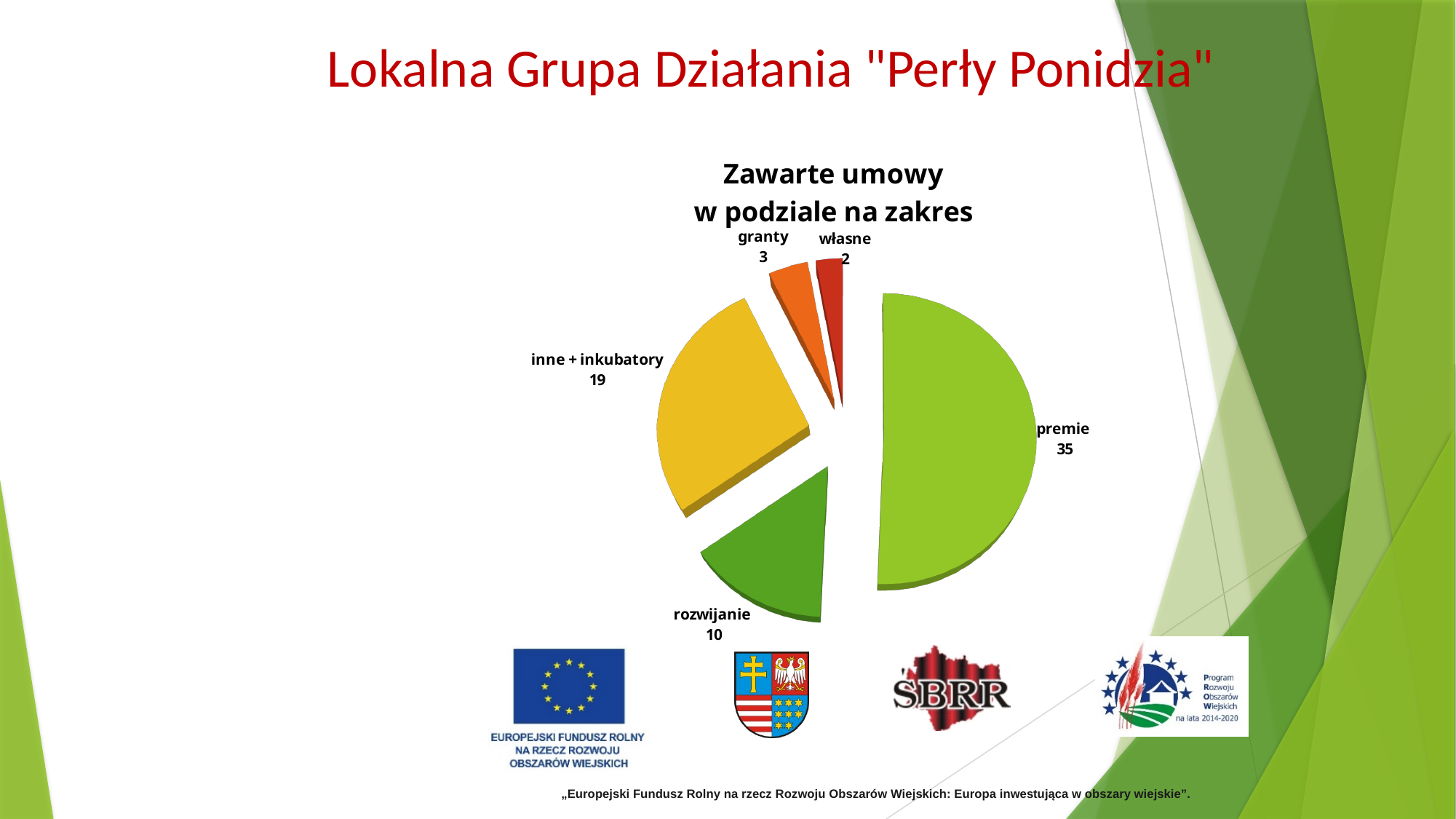
What kind of chart is shown on the slide? pie chart Which is larger, rozwijanie or granty? rozwijanie What is the value for premie? 35 What is the value for inne + inkubatory? 19 How many slices does the pie chart have? 5 What is the value for rozwijanie? 10 What is the value for granty? 3 What is the title of the chart? Zawarte umowy w podziale na zakres What is the difference between the values for premie and inne + inkubatory? 16 Which category has the smallest slice? własne What is the total of all slices in the pie chart? 69 Which category has the largest slice? premie